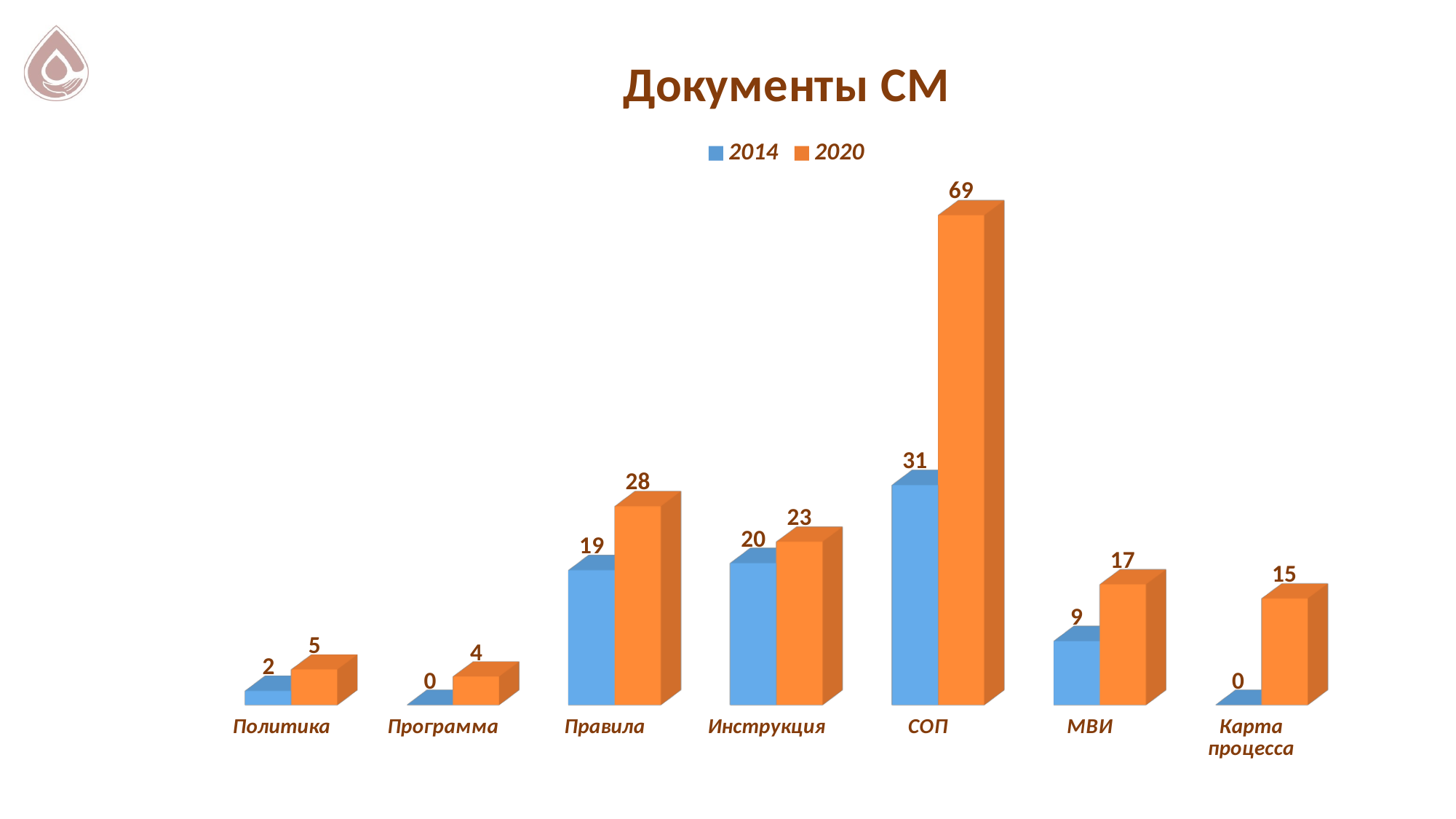
Which category has the lowest value in the 2020 series? Программа What is the value for Карта процесса in the 2014 series? 0 What is the title of the chart? Документы СМ How many series does the legend list? 2 What is the difference between the 2020 and 2014 values for МВИ? 8 What is the value for СОП in the 2020 series? 69 What kind of chart is shown on the slide? bar chart What is the difference between the 2020 and 2014 values for СОП? 38 How many categories are shown on the x axis? 7 Which is larger: the 2014 value for Инструкция or the 2014 value for Правила? Инструкция What is the value for Правила in the 2014 series? 19 Which category has the highest value in the 2020 series? СОП